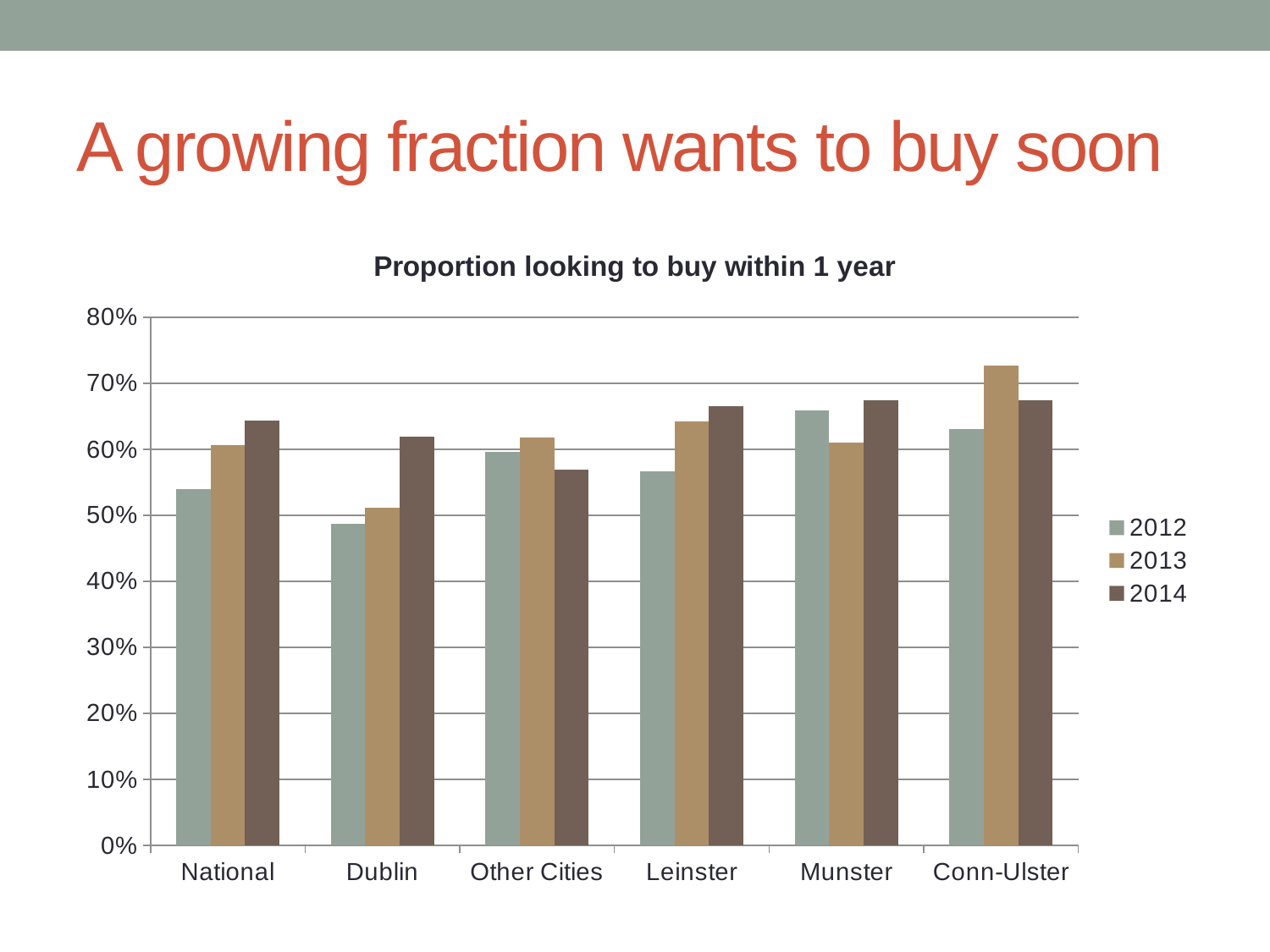
For Other Cities, which is larger: the 2013 value or the 2014 value? 2013 Is the 2014 value for National greater or less than 60%? greater Is the 2013 value for Conn-Ulster greater or less than 70%? greater What is the title of the chart? Proportion looking to buy within 1 year Do the values for Dublin rise or fall from 2012 to 2014? rise Is the 2012 value for Dublin greater or less than 50%? less What kind of chart is shown on the slide? Bar chart How many series does the legend list? 3 For Dublin, which is larger: the 2012 value or the 2014 value? 2014 Which category has the lowest value for 2012? Dublin Which category has the highest value for 2013? Conn-Ulster How many categories are shown on the x axis? 6